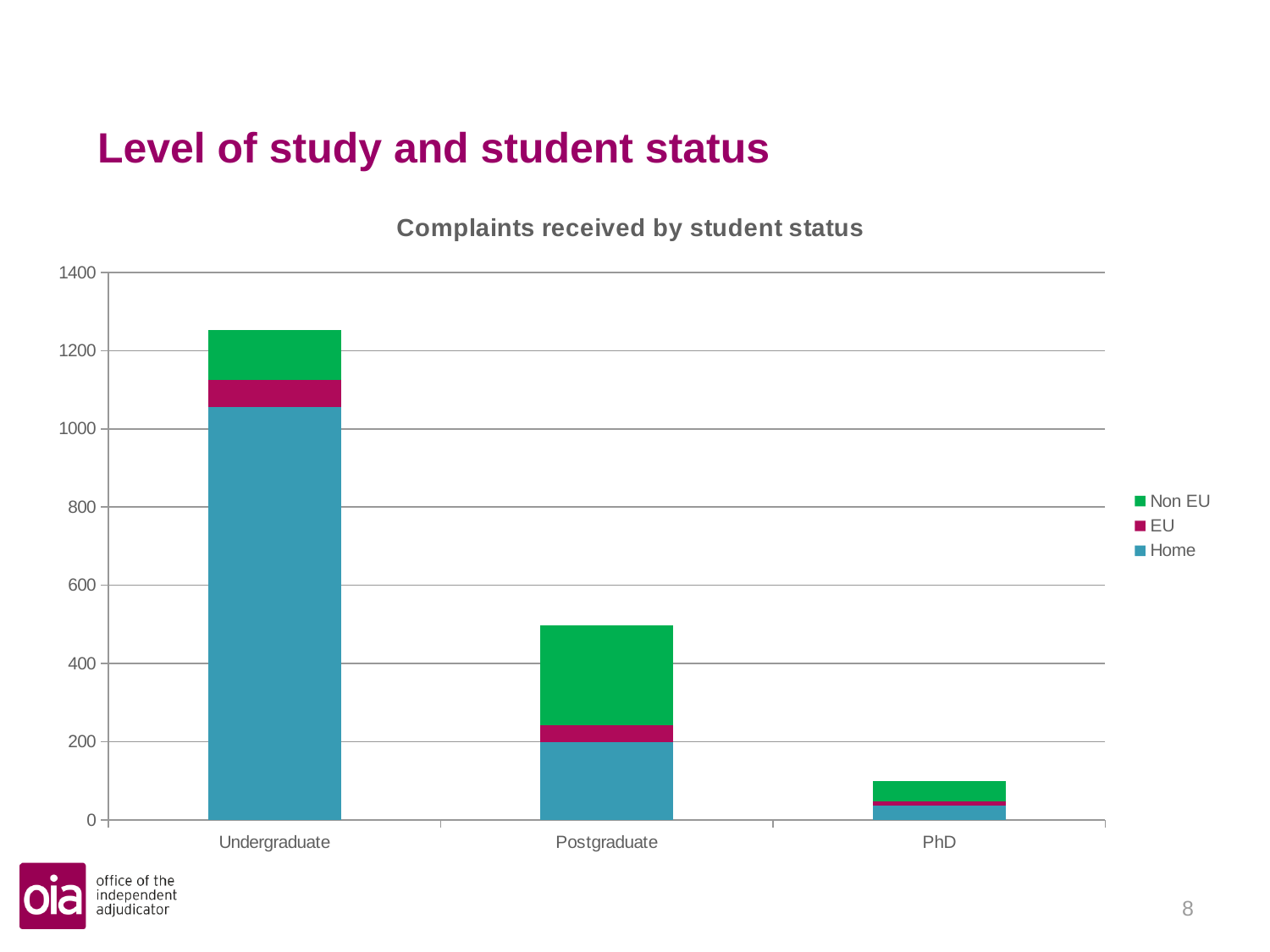
How many series does the legend list? 3 What kind of chart is shown on the slide? Stacked bar chart How many categories are shown on the x axis? 3 What is the title of the chart? Complaints received by student status Which category has the highest total number of complaints? Undergraduate Do the total complaints rise or fall moving from Undergraduate to PhD along the x axis? fall Which category has the lowest total number of complaints? PhD Which series are listed in the legend? Non EU, EU, Home Is the total for Postgraduate greater or less than 600? less Is the total for PhD greater or less than 200? less Is the Home value for Undergraduate greater or less than 1000? greater